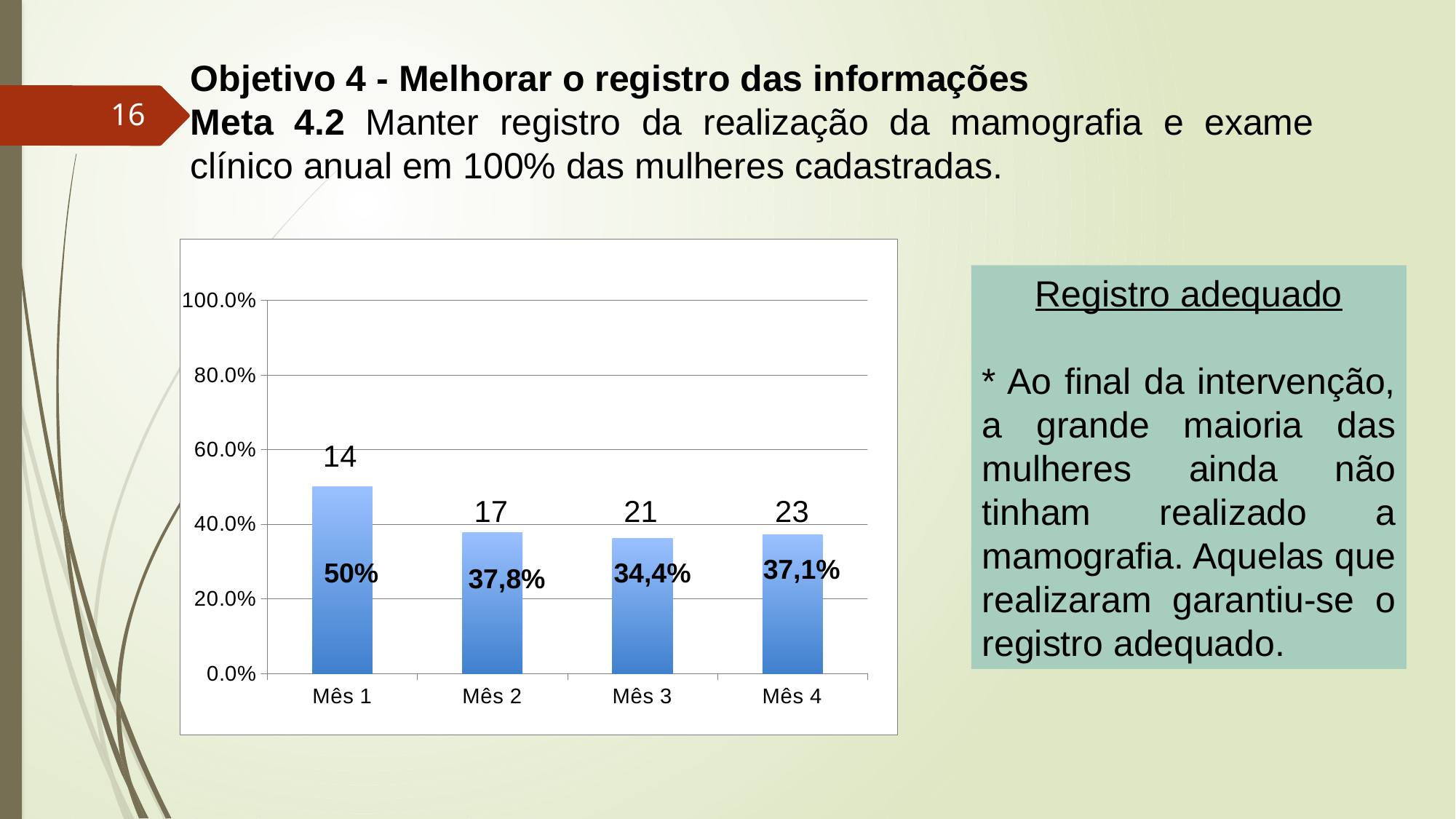
What percentage is shown for Mês 1? 50% Is the value for Mês 1 greater or less than 40.0%? greater What is the difference in percentage between Mês 1 and Mês 2? 12,2% What percentage is shown for Mês 4? 37,1% How many months are shown on the x axis? 4 What number is printed above the bar for Mês 4? 23 What kind of chart is shown on the slide? Bar chart What percentage is shown for Mês 3? 34,4% What percentage is shown for Mês 2? 37,8% What number is printed above the bar for Mês 1? 14 Which month has the lowest percentage? Mês 3 Which month has the highest percentage? Mês 1